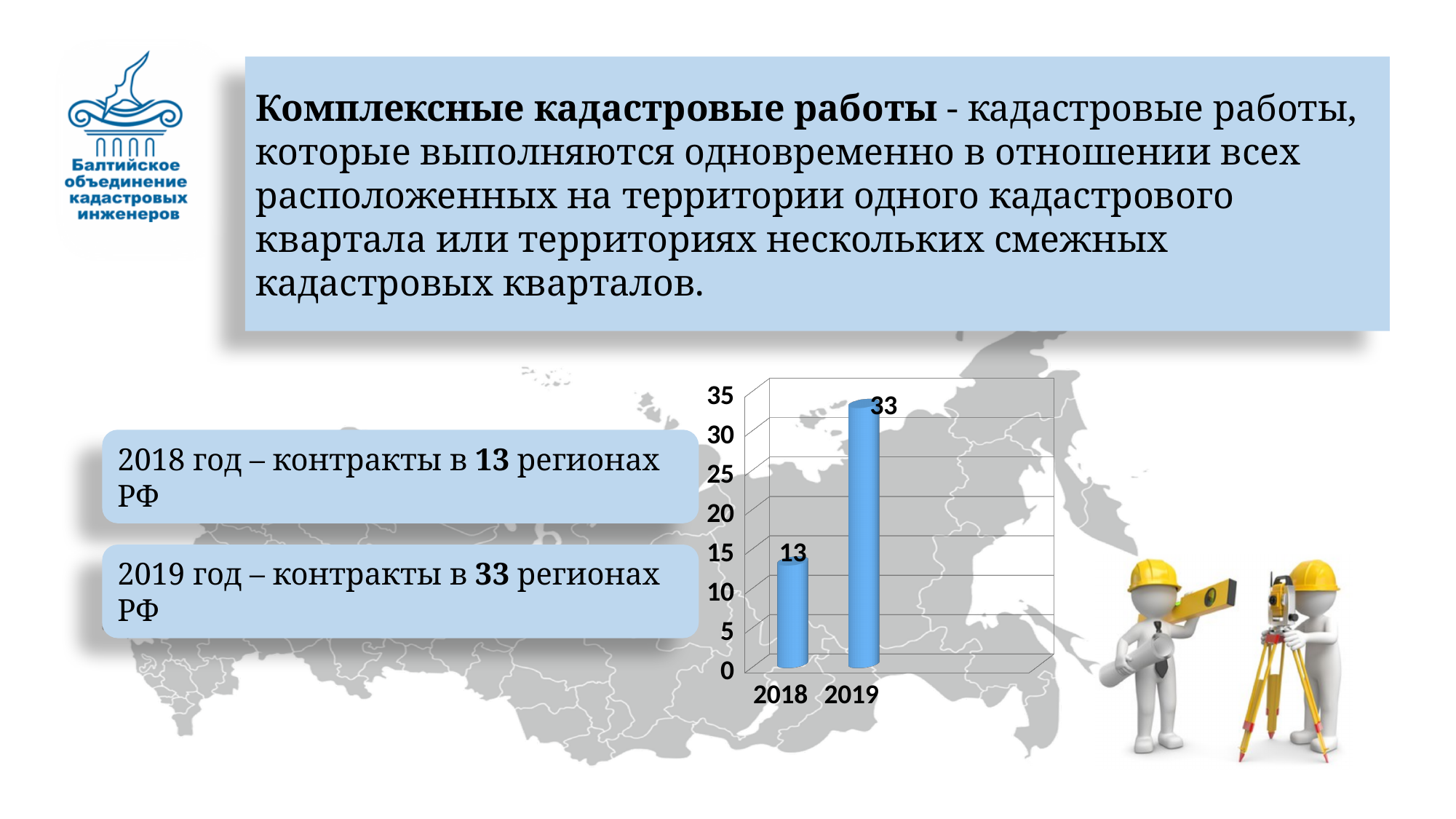
What is the value for 2019 in the bar chart? 33 Which year has the lowest value in the bar chart? 2018 Is the value for 2019 greater or less than 30? greater Which is larger in the bar chart, the value for 2018 or the value for 2019? 2019 Do the values rise or fall from 2018 to 2019 in the bar chart? rise How many categories are shown on the x axis of the bar chart? 2 What is the maximum value shown on the y axis of the bar chart? 35 What is the difference between the values for 2019 and 2018 in the bar chart? 20 Which year has the highest value in the bar chart? 2019 Is the value for 2018 greater or less than 15? less What is the value for 2018 in the bar chart? 13 What kind of chart is shown on the slide? bar chart